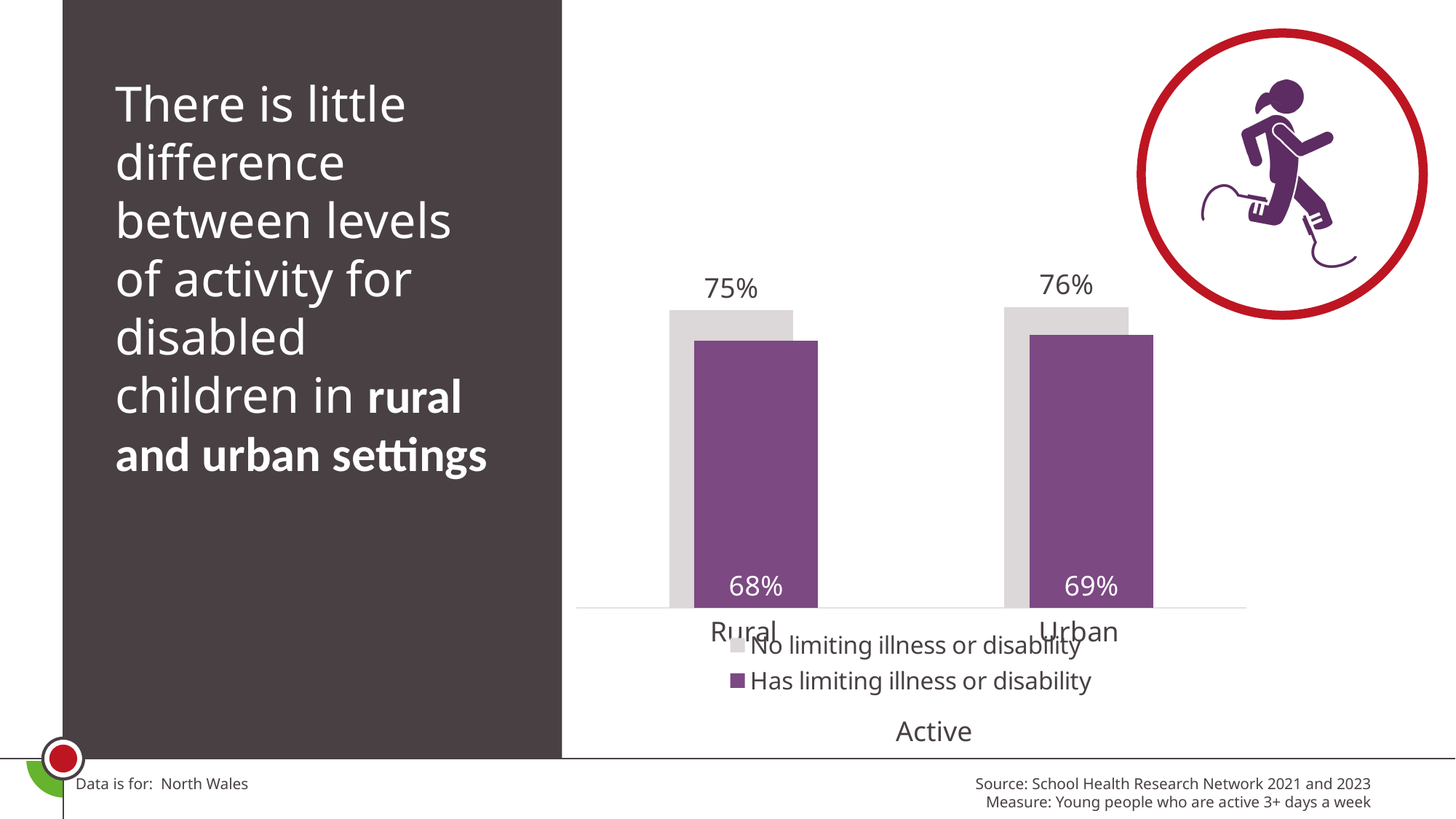
What is the difference between the 'No limiting illness or disability' and 'Has limiting illness or disability' values for Urban? 7% How many categories are shown on the x axis of the chart? 2 What is the title of the chart? Active What is the value for Urban in the 'No limiting illness or disability' series? 76% What is the value for Rural in the 'Has limiting illness or disability' series? 68% What is the difference between the 'No limiting illness or disability' and 'Has limiting illness or disability' values for Rural? 7% What kind of chart is shown on the slide? Bar chart For Rural, which series has the smaller value: 'No limiting illness or disability' or 'Has limiting illness or disability'? Has limiting illness or disability For Urban, which series has the larger value: 'No limiting illness or disability' or 'Has limiting illness or disability'? No limiting illness or disability How many series does the chart's legend list? 2 What is the value for Urban in the 'Has limiting illness or disability' series? 69% What is the value for Rural in the 'No limiting illness or disability' series? 75%